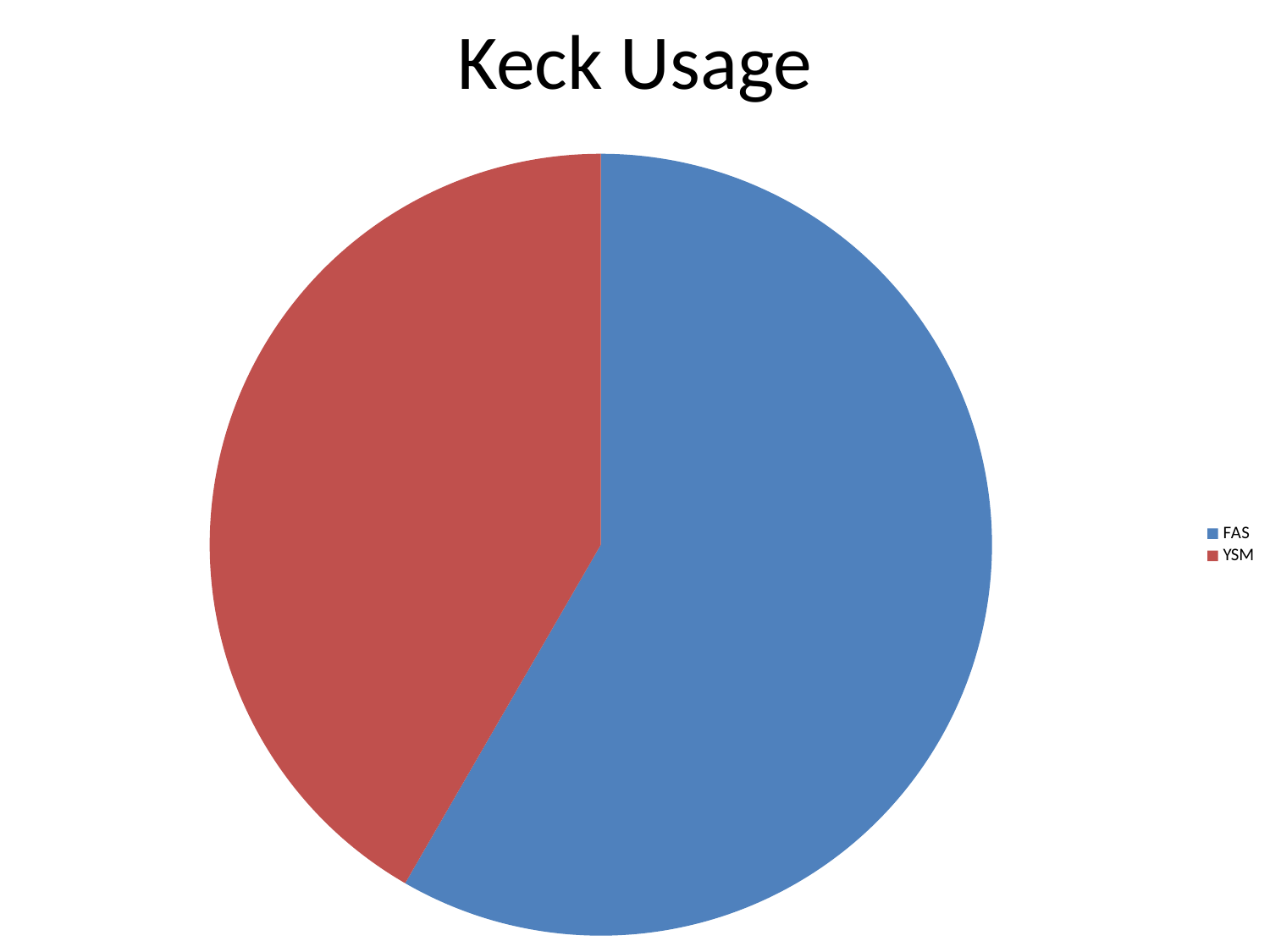
How many entries does the legend list? 2 Which category has the largest slice of the pie? FAS What is the title of the chart? Keck Usage Is the share of the pie for YSM greater or less than 50%? less Which is larger, the FAS slice or the YSM slice? FAS What kind of chart is shown on the slide? pie chart Which colour represents FAS in the chart? blue How many slices does the pie chart have? 2 Is the share of the pie for FAS greater or less than 50%? greater Which category has the smallest slice of the pie? YSM